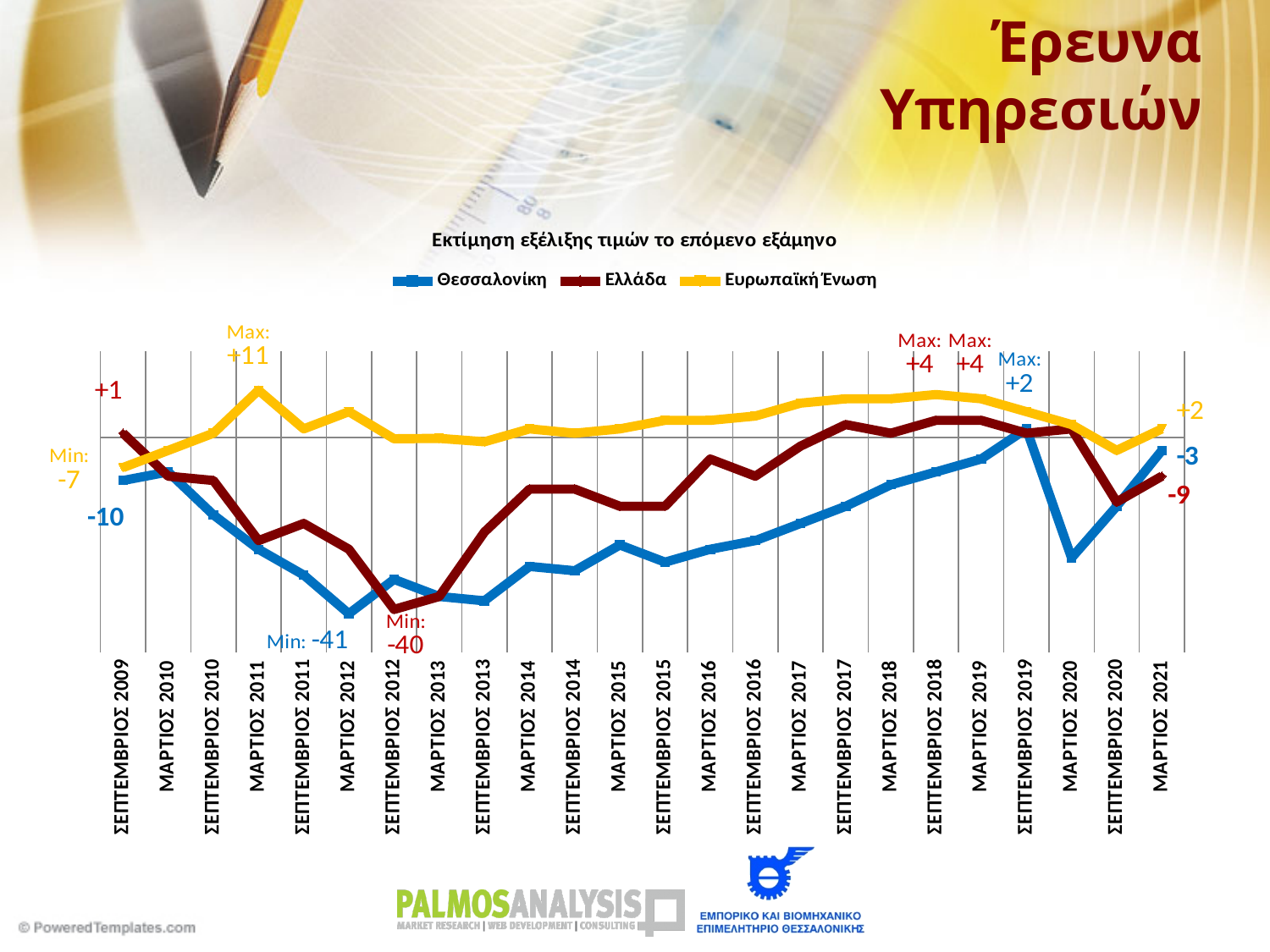
Which series has the highest value in ΜΑΡΤΙΟΣ 2021? Ευρωπαϊκή Ένωση What is the value for Ελλάδα in ΜΑΡΤΙΟΣ 2021? -9 What is the minimum value reached by the Θεσσαλονίκη series? -41 In ΜΑΡΤΙΟΣ 2021, which is higher: Θεσσαλονίκη or Ελλάδα? Θεσσαλονίκη What is the minimum value reached by the Ελλάδα series? -40 What is the value for Θεσσαλονίκη in ΣΕΠΤΕΜΒΡΙΟΣ 2009? -10 How many series does the legend list? 3 What is the value for Ελλάδα in ΣΕΠΤΕΜΒΡΙΟΣ 2009? +1 How many time points are shown on the x axis? 24 What is the maximum value reached by the Ευρωπαϊκή Ένωση series? +11 What is the difference between the Ευρωπαϊκή Ένωση and Ελλάδα values in ΜΑΡΤΙΟΣ 2021? 11 What kind of chart is shown on the slide? Line chart